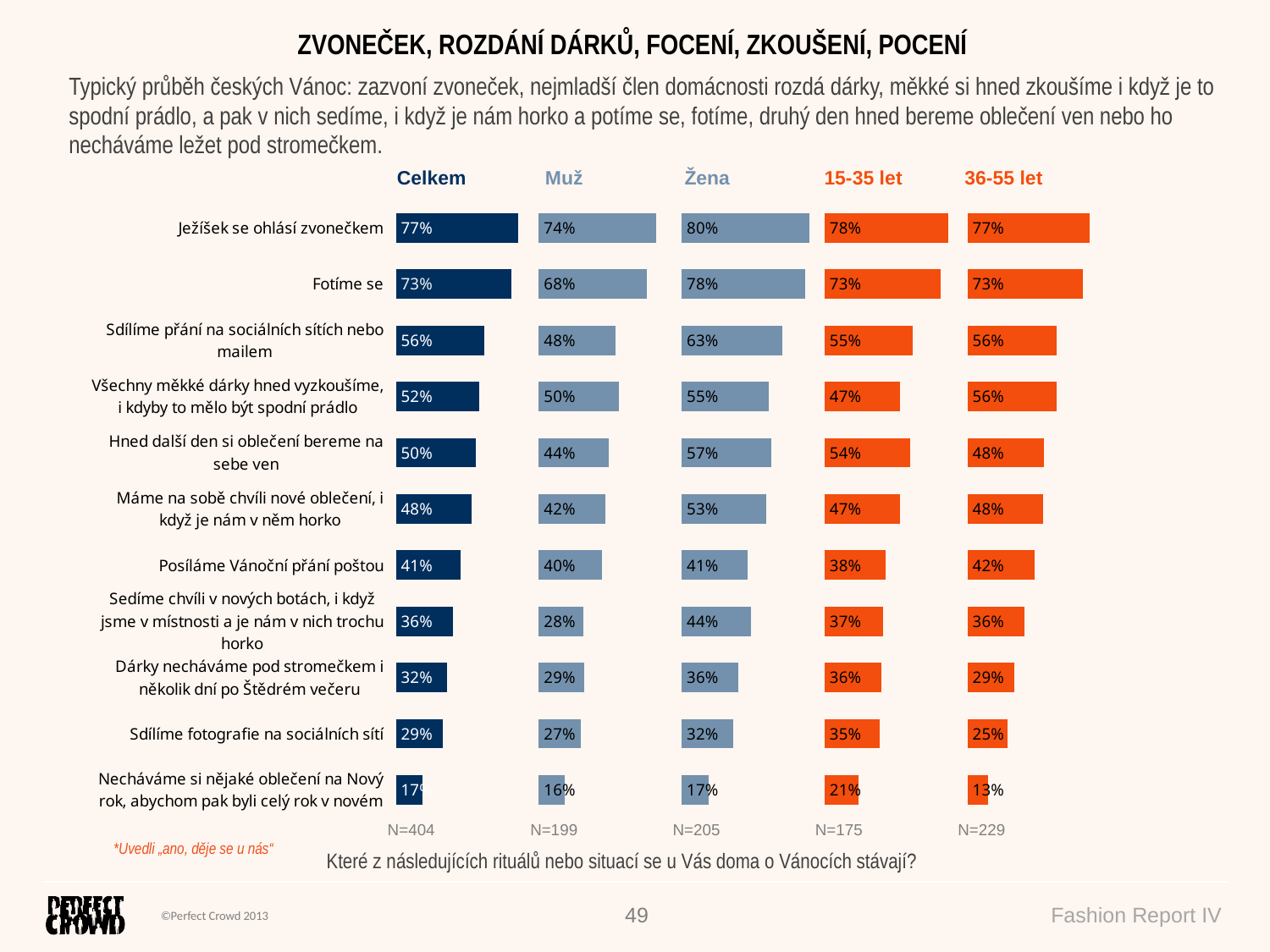
How many categories are shown in the Celkem chart? 11 In the 15-35 let chart, what is the value for "Sdílíme fotografie na sociálních sítí"? 35% In the 36-55 let chart, which category has the lowest value? Necháváme si nějaké oblečení na Nový rok, abychom pak byli celý rok v novém In the Celkem chart, what is the value for "Ježíšek se ohlásí zvonečkem"? 77% In the Žena chart, which category has the highest value? Ježíšek se ohlásí zvonečkem What is the sample size (N) shown under the Žena chart? N=205 What kind of chart is used to show the Celkem values? Bar chart In the Muž chart, what is the value for "Fotíme se"? 68% For "Hned další den si oblečení bereme na sebe ven", which is larger: the 15-35 let value or the 36-55 let value? 15-35 let In the Žena chart, what is the value for "Sdílíme přání na sociálních sítích nebo mailem"? 63% What is the difference between the Žena and Muž values for "Sedíme chvíli v nových botách, i když jsme v místnosti a je nám v nich trochu horko"? 16% How many group columns (charts) are shown side by side on the slide? 5